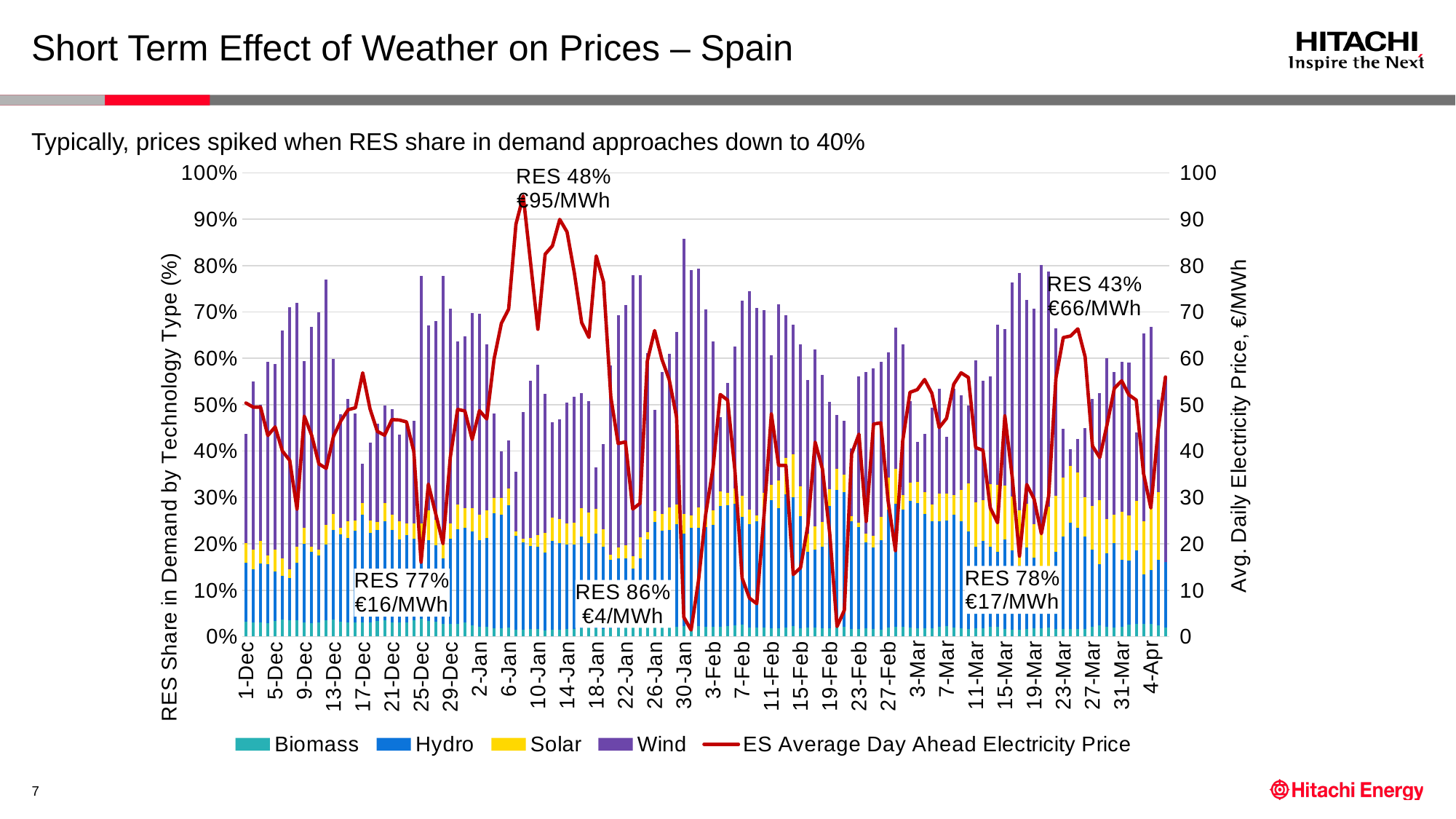
What is the title of the right-hand vertical axis? Avg. Daily Electricity Price, €/MWh What RES share is annotated alongside the €95/MWh price peak? 48% How many technology types are stacked in the bars? 4 What kind of chart is shown on the slide? A combination chart of stacked bars and a line What electricity price is annotated at the highest peak of the price line? €95/MWh What electricity price is annotated alongside the RES 86% label? €4/MWh How many series does the legend list? 5 Is the electricity price at its peak around 6-Jan greater or less than 90 €/MWh? greater Which series is plotted as the red line? ES Average Day Ahead Electricity Price Is the electricity price around 30-Jan greater or less than 10 €/MWh? less What RES share is annotated alongside the €66/MWh price? 43% What electricity price is annotated alongside the RES 77% label? €16/MWh